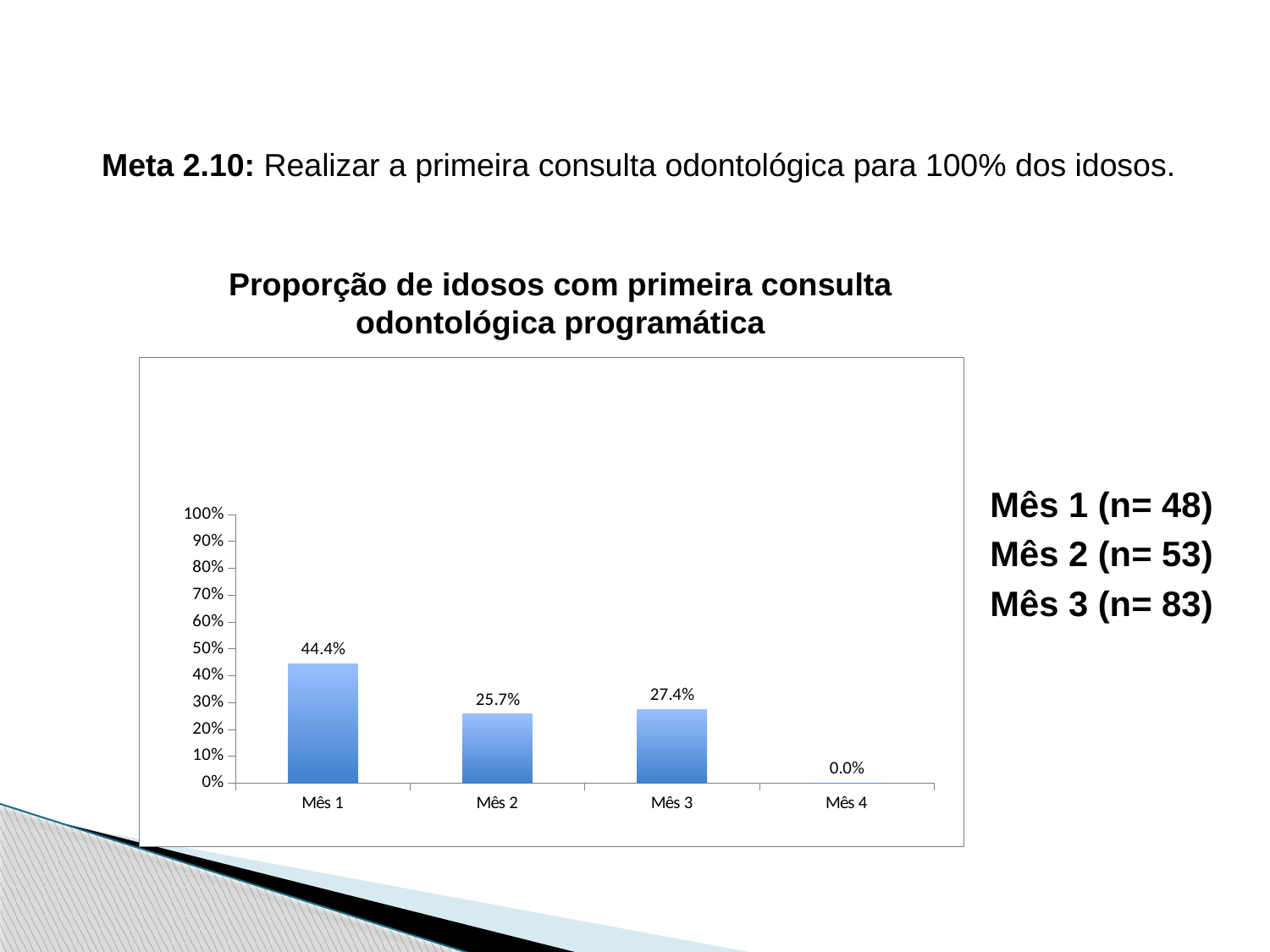
Which month has the lowest value? Mês 4 Which is larger, the value for Mês 1 or the value for Mês 3? Mês 1 What is the value for Mês 3? 27.4% How many months are shown on the x axis? 4 What is the title of the chart? Proporção de idosos com primeira consulta odontológica programática Is the value for Mês 1 greater or less than 40%? greater What kind of chart is shown? Bar chart Which month has the highest value? Mês 1 What is the value for Mês 4? 0.0% What is the value for Mês 2? 25.7% What is the value for Mês 1? 44.4% What is the difference between the values for Mês 1 and Mês 2? 18.7%